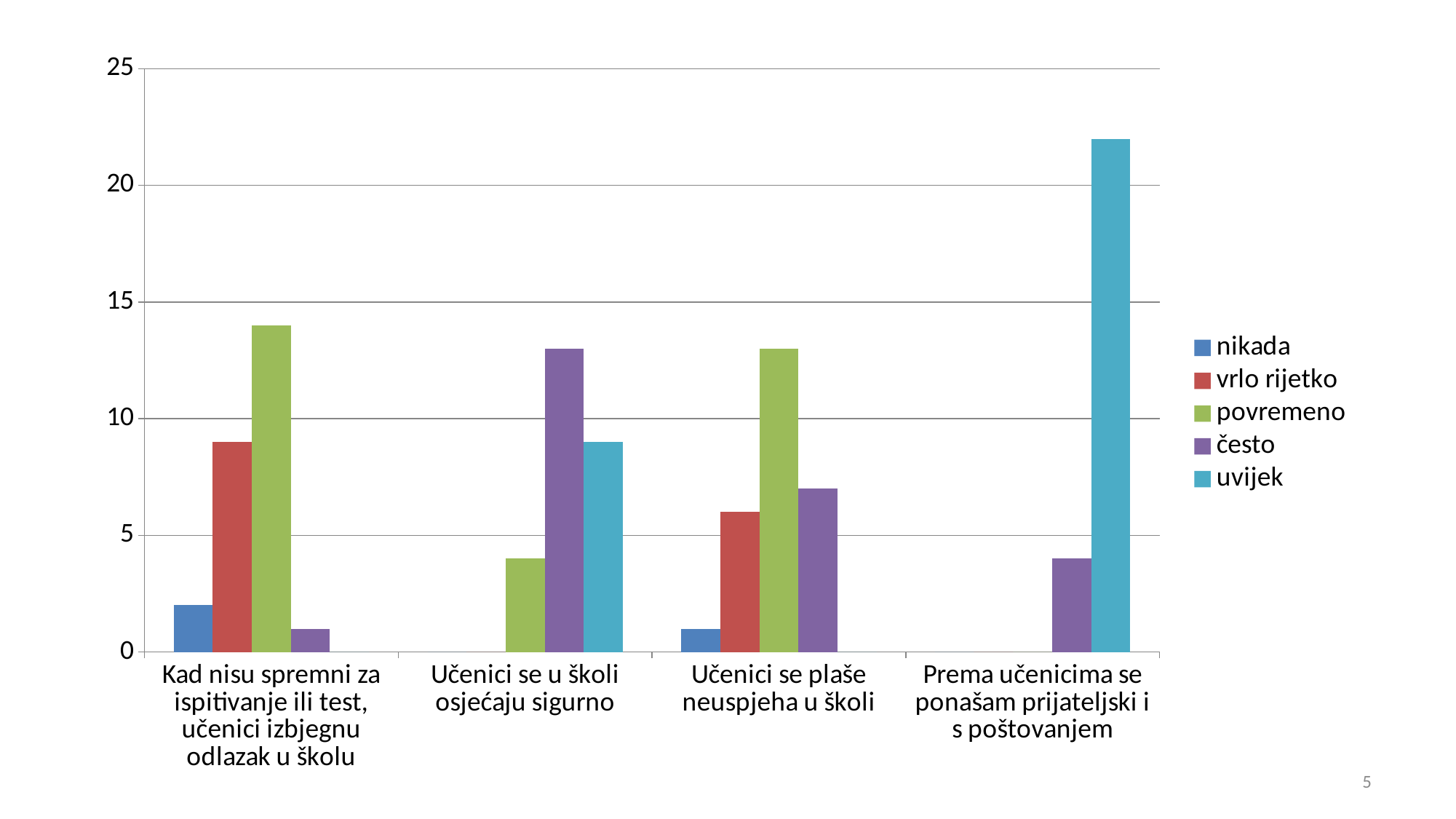
What kind of chart is shown on the slide? bar chart Is the value for 'uvijek' in the category 'Prema učenicima se ponašam prijateljski i s poštovanjem' greater or less than 20? greater What colour are the bars for the 'uvijek' series? light blue (cyan) Is the value for 'povremeno' in the category 'Kad nisu spremni za ispitivanje ili test, učenici izbjegnu odlazak u školu' greater or less than 15? less Is the value for 'često' in the category 'Učenici se u školi osjećaju sigurno' greater or less than 10? greater How many series does the legend list? 5 Which series has the lowest non-zero value in the category 'Kad nisu spremni za ispitivanje ili test, učenici izbjegnu odlazak u školu'? često Which series has the highest value in the category 'Učenici se plaše neuspjeha u školi'? povremeno In which category does the 'uvijek' series reach its highest value? Prema učenicima se ponašam prijateljski i s poštovanjem Which series has the tallest bar in the whole chart? uvijek In the category 'Učenici se u školi osjećaju sigurno', which is larger: 'često' or 'uvijek'? često How many categories are shown on the x axis? 4